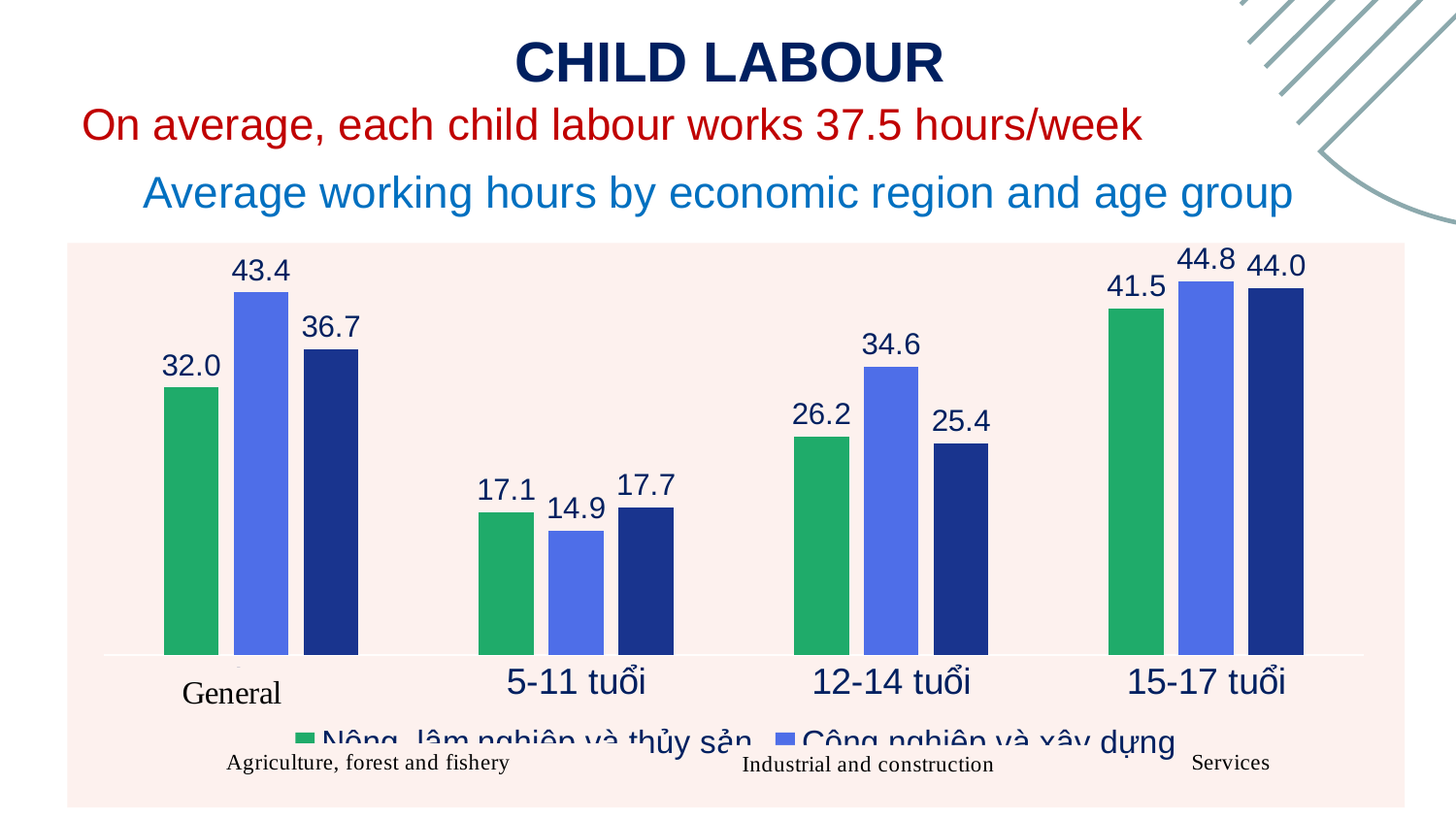
Do the Services values rise or fall from the 5-11 tuổi group to the 15-17 tuổi group? Rise How many series does the legend list? 3 What is the value for Industrial and construction in the 15-17 tuổi group? 44.8 In the 12-14 tuổi group, which is larger: Agriculture, forest and fishery or Services? Agriculture, forest and fishery Which category has the lowest value for Industrial and construction? 5-11 tuổi How many categories are shown on the x axis? 4 What is the value for Agriculture, forest and fishery in the 5-11 tuổi group? 17.1 Which age group has the highest value for Agriculture, forest and fishery? 15-17 tuổi What is the difference between the Industrial and construction and Agriculture, forest and fishery values in the General category? 11.4 What is the average working hours for Industrial and construction in the General category? 43.4 What is the value for Services in the 12-14 tuổi group? 25.4 What kind of chart is shown on the slide? Bar chart